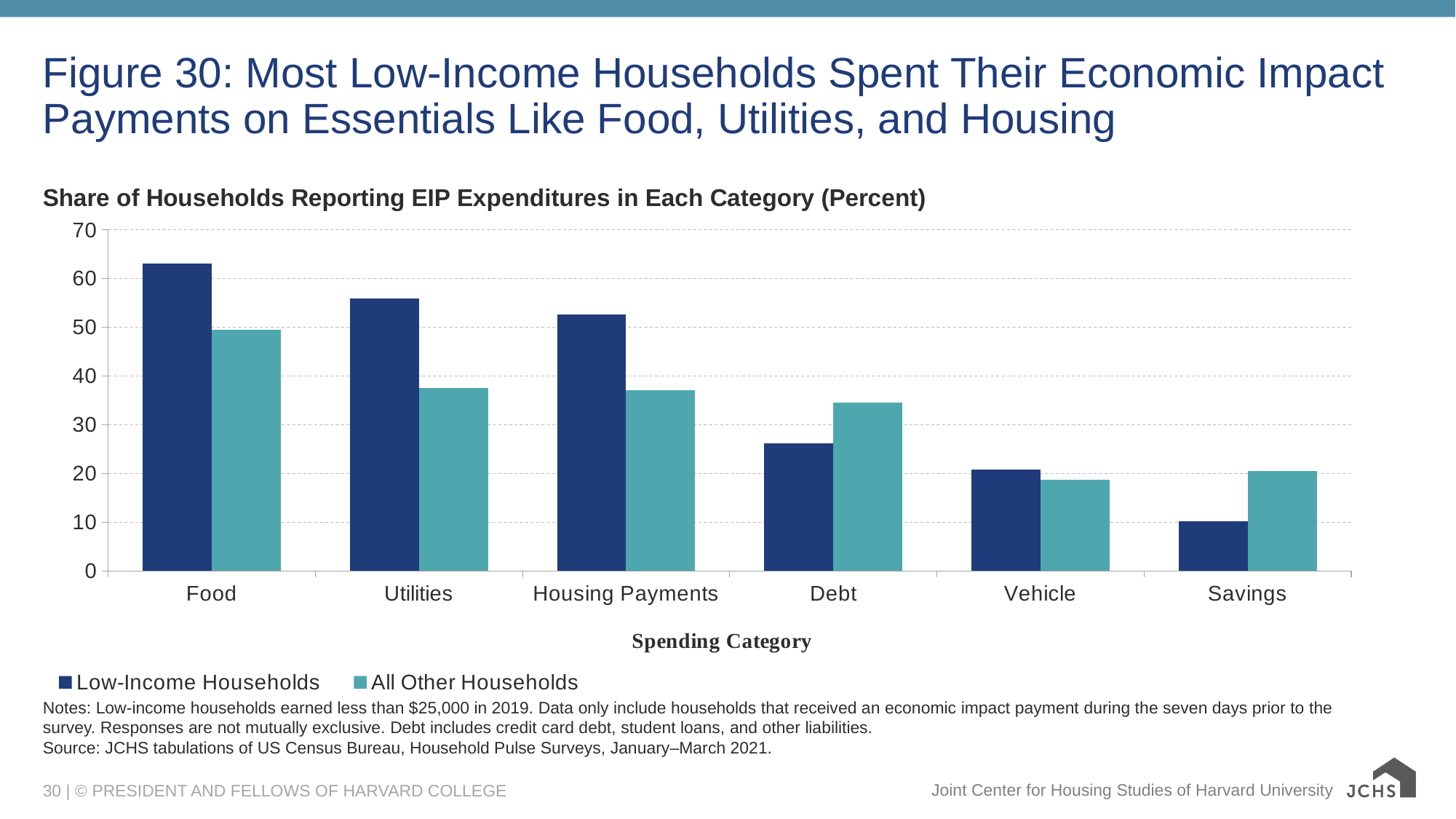
Which spending category has the highest value for Low-Income Households? Food What is the label of the x axis? Spending Category Is the value for All Other Households in the Debt category greater or less than 30? greater Which spending category has the highest value for All Other Households? Food Is the value for Low-Income Households in the Food category greater or less than 60? greater In the Savings category, which series has the larger value: Low-Income Households or All Other Households? All Other Households Which spending category has the lowest value for Low-Income Households? Savings How many spending categories are shown on the x axis? 6 Is the value for Low-Income Households in the Savings category greater or less than 20? less What kind of chart is shown on the slide? bar chart How many series does the legend list? 2 In the Utilities category, which series has the larger value: Low-Income Households or All Other Households? Low-Income Households